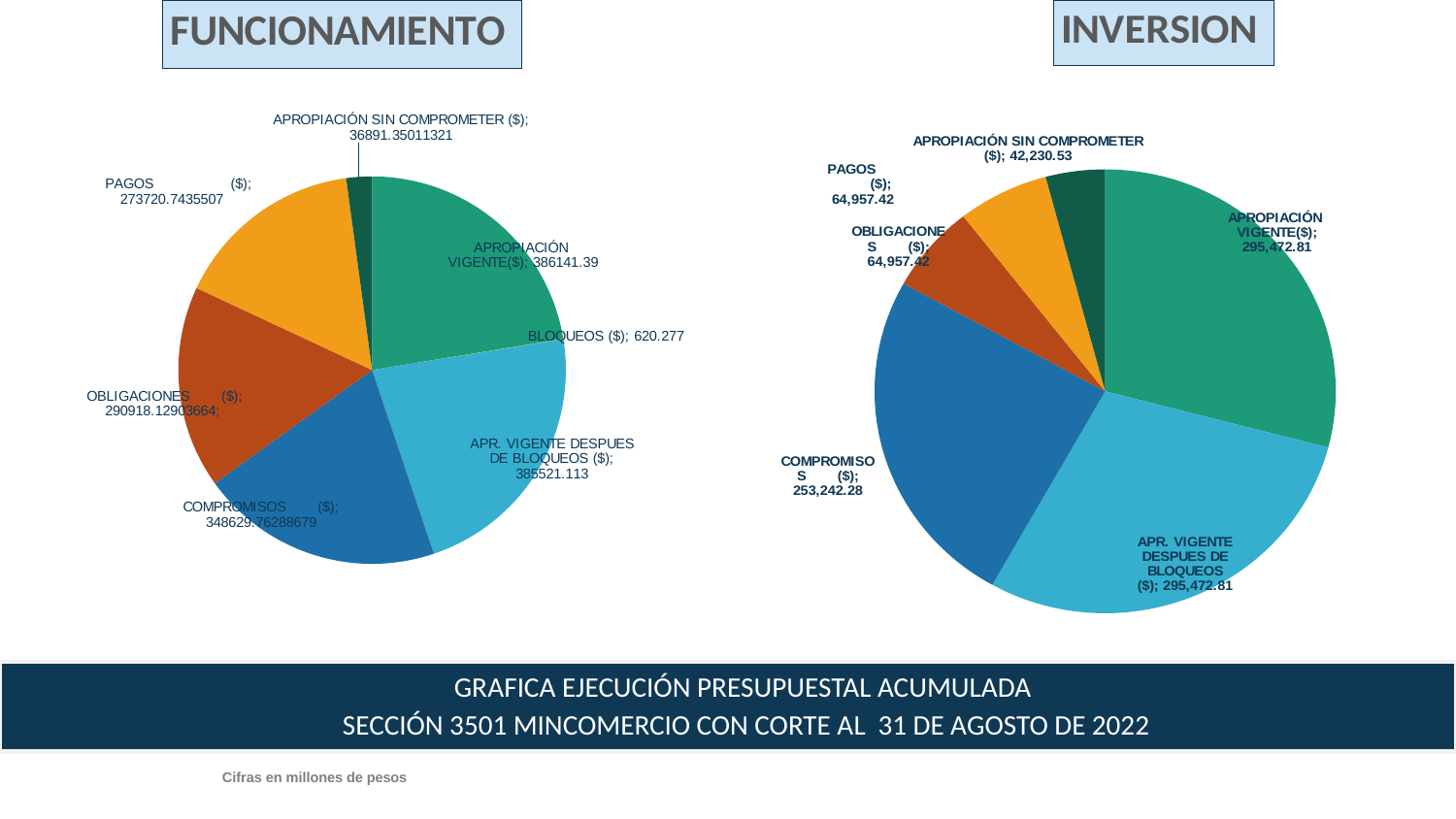
In the FUNCIONAMIENTO chart, what is the difference between APROPIACIÓN VIGENTE($) and APR. VIGENTE DESPUES DE BLOQUEOS ($)? 620.277 In the INVERSION chart, what is the value for COMPROMISOS ($)? 253,242.28 In the INVERSION chart, which category has the smallest slice? APROPIACIÓN SIN COMPROMETER ($) In the FUNCIONAMIENTO chart, which category has the smallest slice? BLOQUEOS ($) In the INVERSION chart, what is the difference between APROPIACIÓN VIGENTE($) and COMPROMISOS ($)? 42,230.53 How many slices does the INVERSION pie chart have? 6 In the FUNCIONAMIENTO chart, what is the value for BLOQUEOS ($)? 620.277 What type of chart is the FUNCIONAMIENTO chart? Pie chart In the FUNCIONAMIENTO chart, what is the value for COMPROMISOS ($)? 348629.76288679 In the INVERSION chart, what is the value for APROPIACIÓN SIN COMPROMETER ($)? 42,230.53 How many slices does the FUNCIONAMIENTO pie chart have? 7 In the FUNCIONAMIENTO chart, which is larger: OBLIGACIONES ($) or PAGOS ($)? OBLIGACIONES ($)